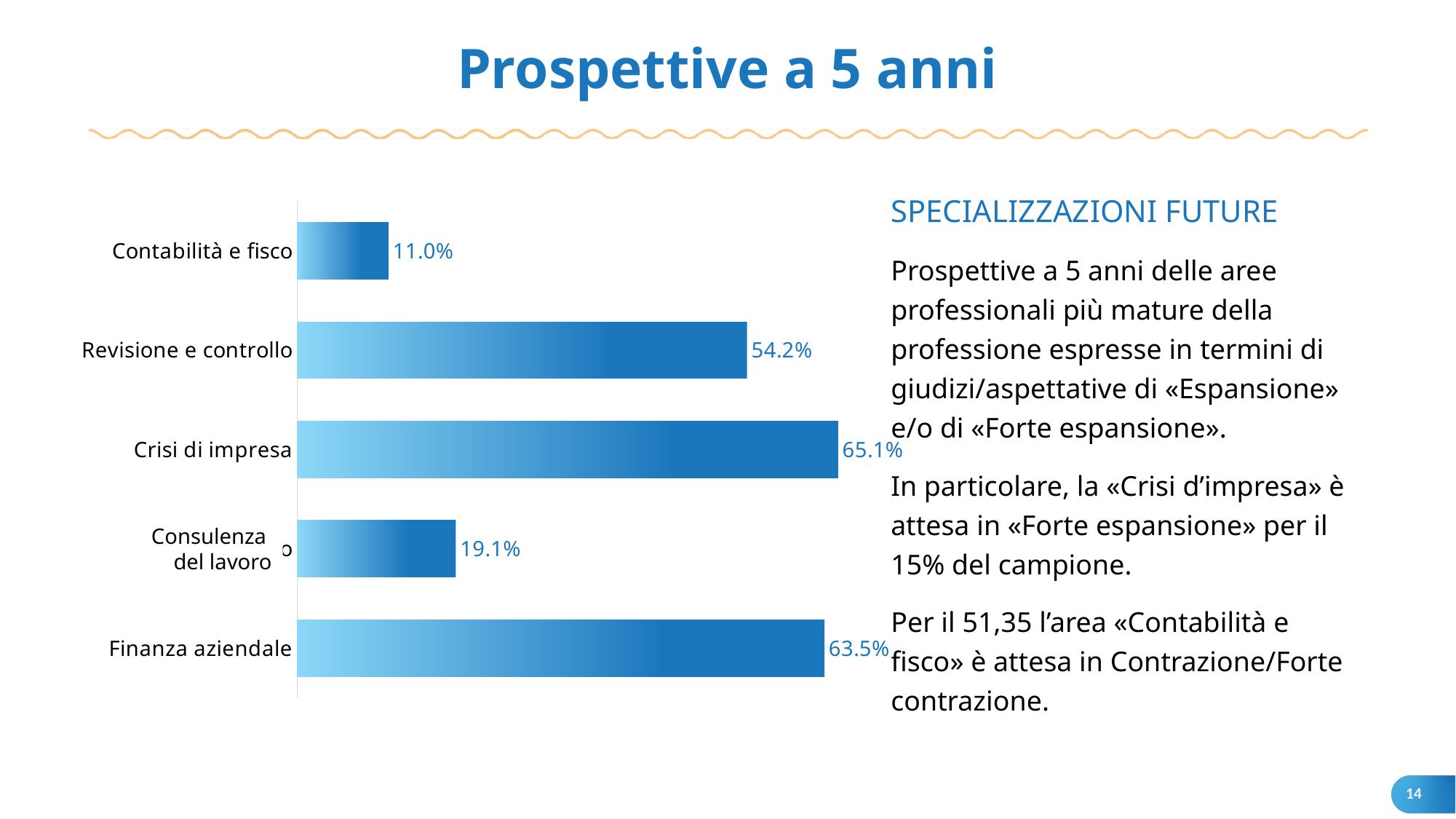
What kind of chart is shown on the slide? Bar chart Which is larger, the value for Revisione e controllo or the value for Consulenza del lavoro? Revisione e controllo What is the value for Crisi di impresa? 65.1% Which category has the highest value? Crisi di impresa What is the value for Consulenza del lavoro? 19.1% What is the value for Revisione e controllo? 54.2% What is the value for Contabilità e fisco? 11.0% What is the value for Finanza aziendale? 63.5% What is the difference between the values for Crisi di impresa and Finanza aziendale? 1.6 percentage points Which category has the lowest value? Contabilità e fisco How many categories are shown in the chart? 5 What is the difference between the values for Revisione e controllo and Contabilità e fisco? 43.2 percentage points